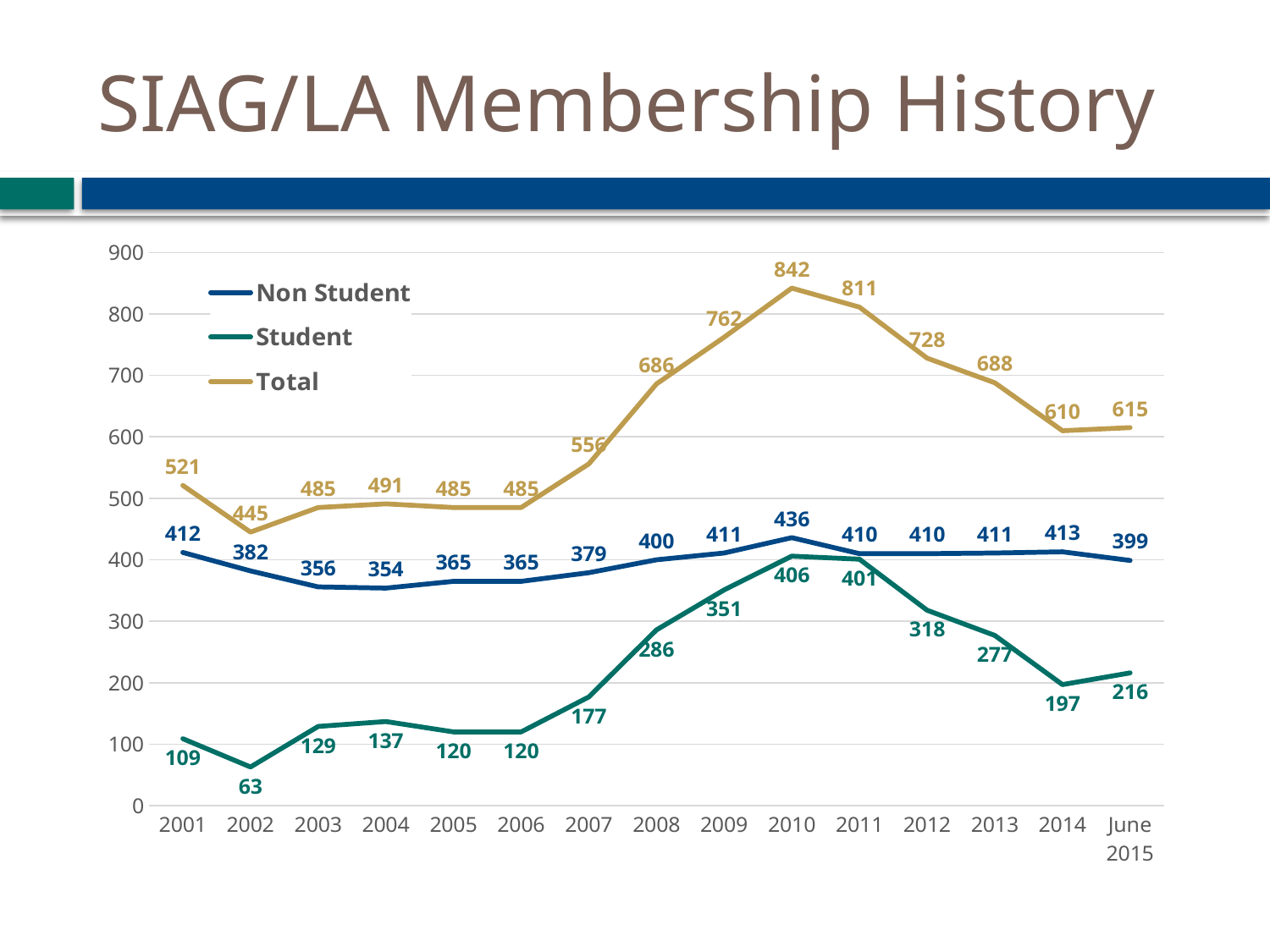
How many points along the x axis does the chart show? 15 Did the Student membership rise or fall from 2010 to 2014? Fall What was the Total membership in 2010? 842 What kind of chart is shown on the slide? Line chart What was the Student membership in 2002? 63 In which year did the Total series reach its highest value? 2010 In which year was the Student membership lowest? 2002 Which was larger in 2011: Non Student membership or Student membership? Non Student What was the Non Student membership in June 2015? 399 How many series does the legend list? 3 What is the difference between the Total membership in 2010 and in 2011? 31 What is the title of the slide? SIAG/LA Membership History